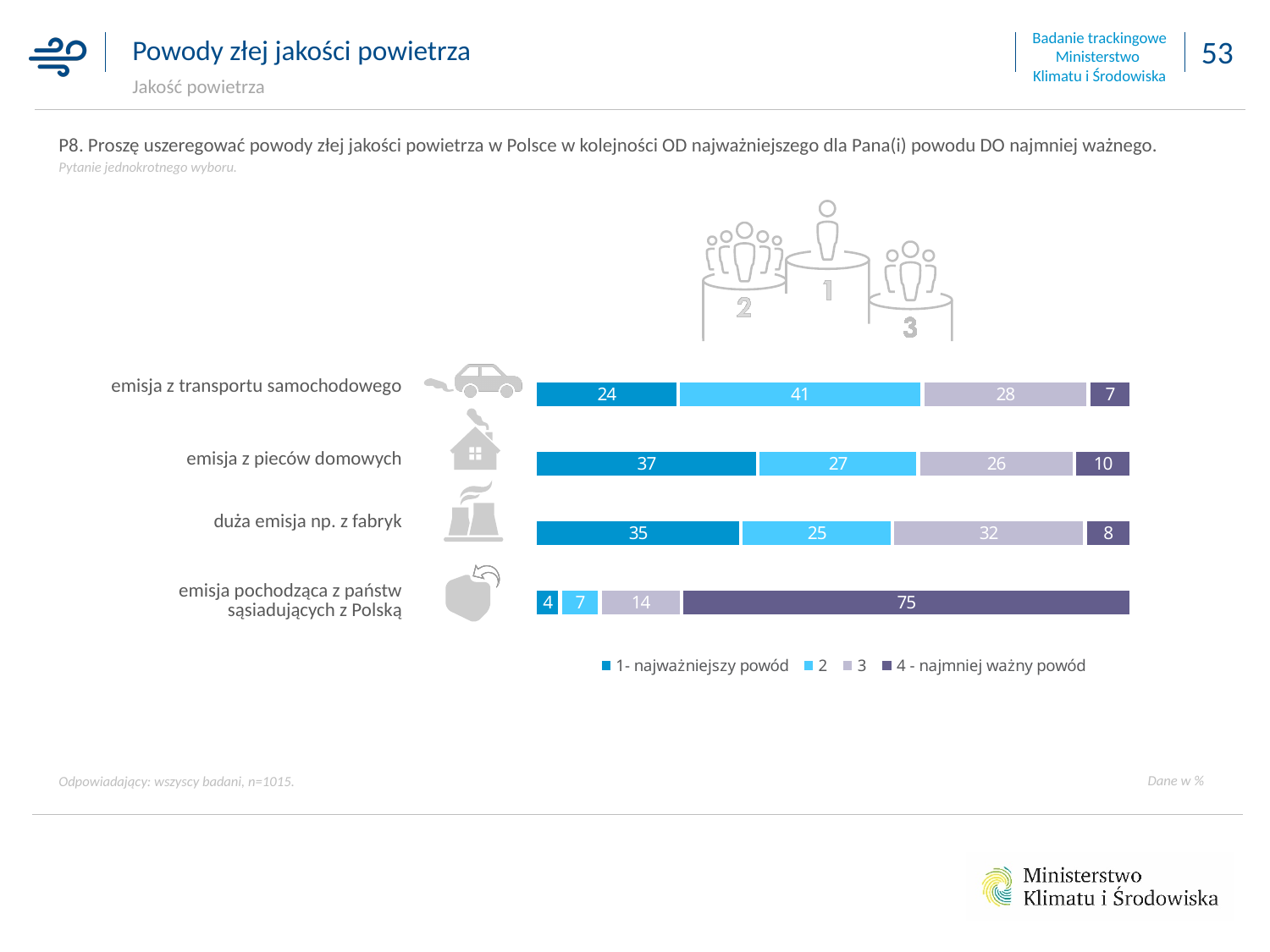
What is the difference between the "1- najważniejszy powód" values for "emisja z pieców domowych" and "emisja z transportu samochodowego"? 13 Which category has the highest value for "1- najważniejszy powód"? emisja z pieców domowych What is the total of the stacked bar for "emisja z pieców domowych"? 100 What is the value for series 3 for "duża emisja np. z fabryk"? 32 What kind of chart is shown on the slide? stacked bar chart Which category has the lowest value for "1- najważniejszy powód"? emisja pochodząca z państw sąsiadujących z Polską What is the value for "4 - najmniej ważny powód" for "emisja pochodząca z państw sąsiadujących z Polską"? 75 How many series does the legend list? 4 What is the value for "1- najważniejszy powód" for "emisja z pieców domowych"? 37 What percentage of respondents ranked "emisja z transportu samochodowego" as 2? 41 Which is larger: the series 2 value for "emisja z transportu samochodowego" or for "duża emisja np. z fabryk"? emisja z transportu samochodowego How many categories are shown in the chart? 4